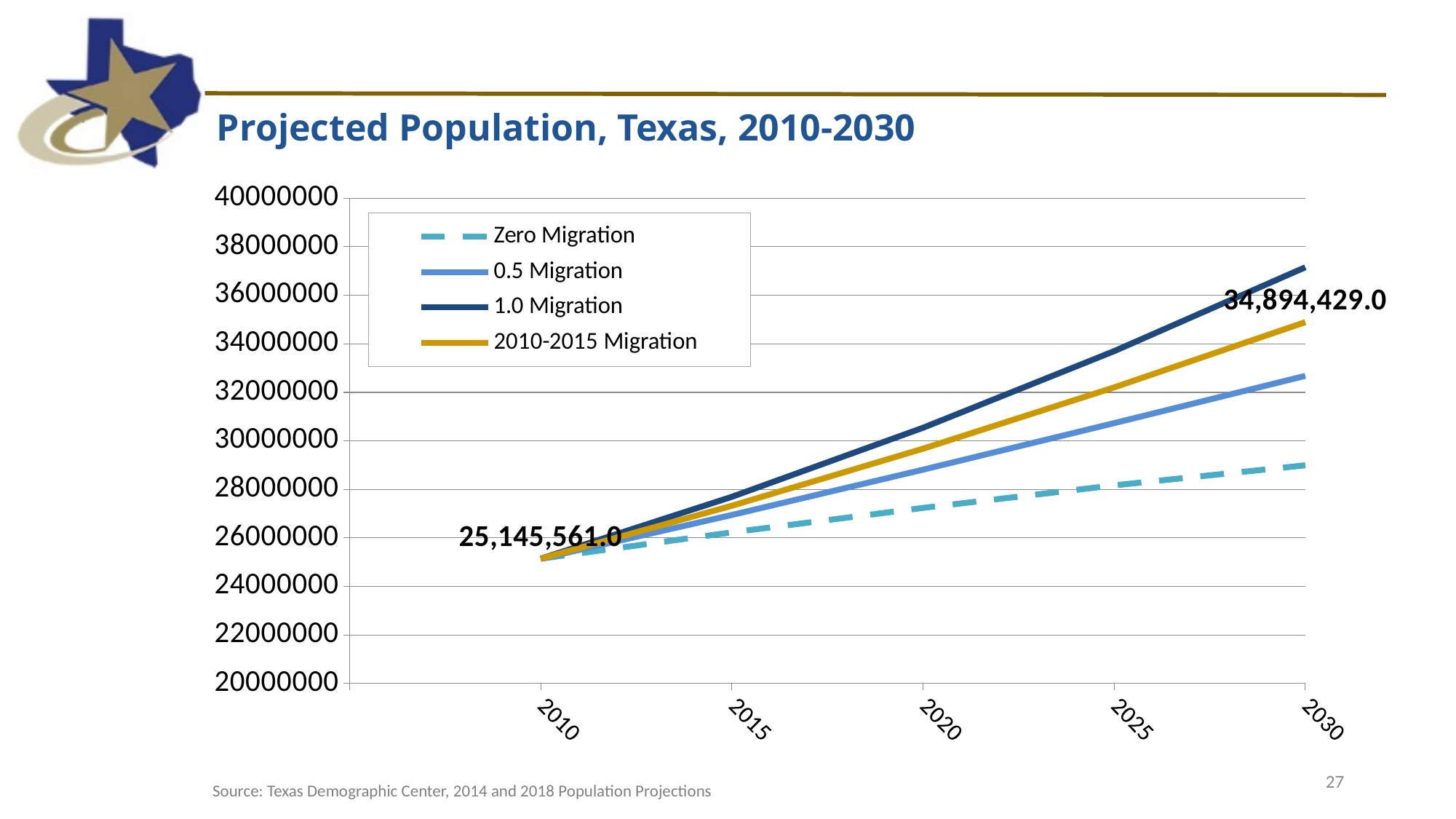
What is the labelled value for the 2010-2015 Migration series in 2030? 34,894,429.0 How many years are labelled on the x axis? 5 How many series does the legend list? 4 What is the labelled population value at 2010? 25,145,561.0 Which series has the lowest value in 2030? Zero Migration Do the projected population values rise or fall from 2010 to 2030? rise Which series has the highest value in 2030? 1.0 Migration Which series is drawn with a dashed line? Zero Migration In 2030, which is larger: 1.0 Migration or 0.5 Migration? 1.0 Migration What kind of chart is shown on the slide? line chart What is the difference between the labelled 2030 value for 2010-2015 Migration and the labelled 2010 value? 9,748,868.0 Is the value for Zero Migration in 2030 greater or less than 30000000? less